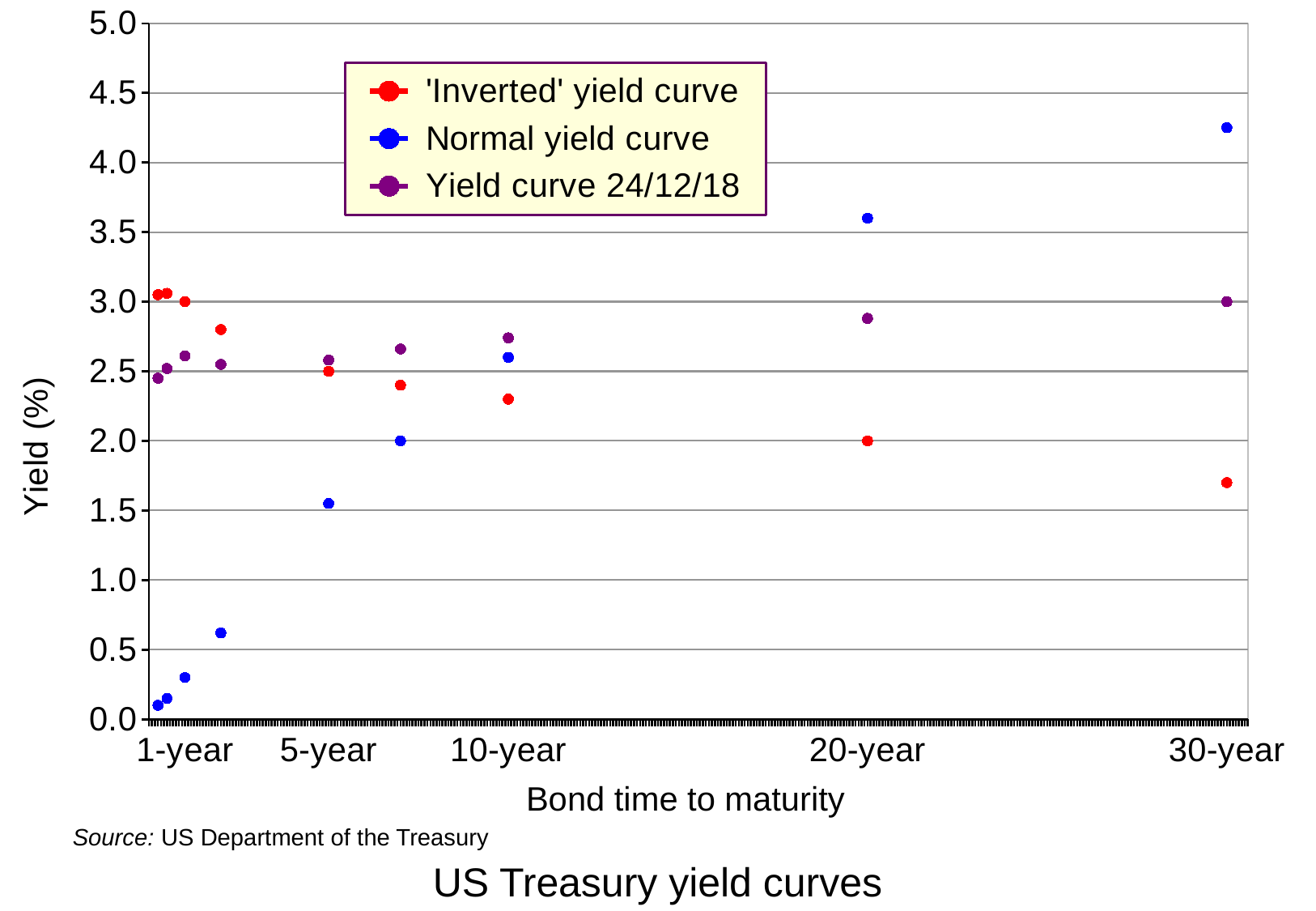
At 30-year, which is larger: the Normal yield curve or the 'Inverted' yield curve? Normal yield curve What kind of chart is shown on the slide? scatter chart Do the values of the Normal yield curve rise or fall as bond time to maturity increases? rise How many series does the legend list? 3 What is the value of the Yield curve 24/12/18 series at 30-year? 3.0 Is the value for the 'Inverted' yield curve at 30-year greater or less than 2.0? less Is the value for the Normal yield curve at 30-year greater or less than 4.0? greater What is the title of the chart? US Treasury yield curves What is the label of the y axis? Yield (%) What is the value of the 'Inverted' yield curve at 20-year? 2.0 At which maturity is the Normal yield curve lowest? 1-year Is the value for the Normal yield curve at 1-year greater or less than 0.5? less